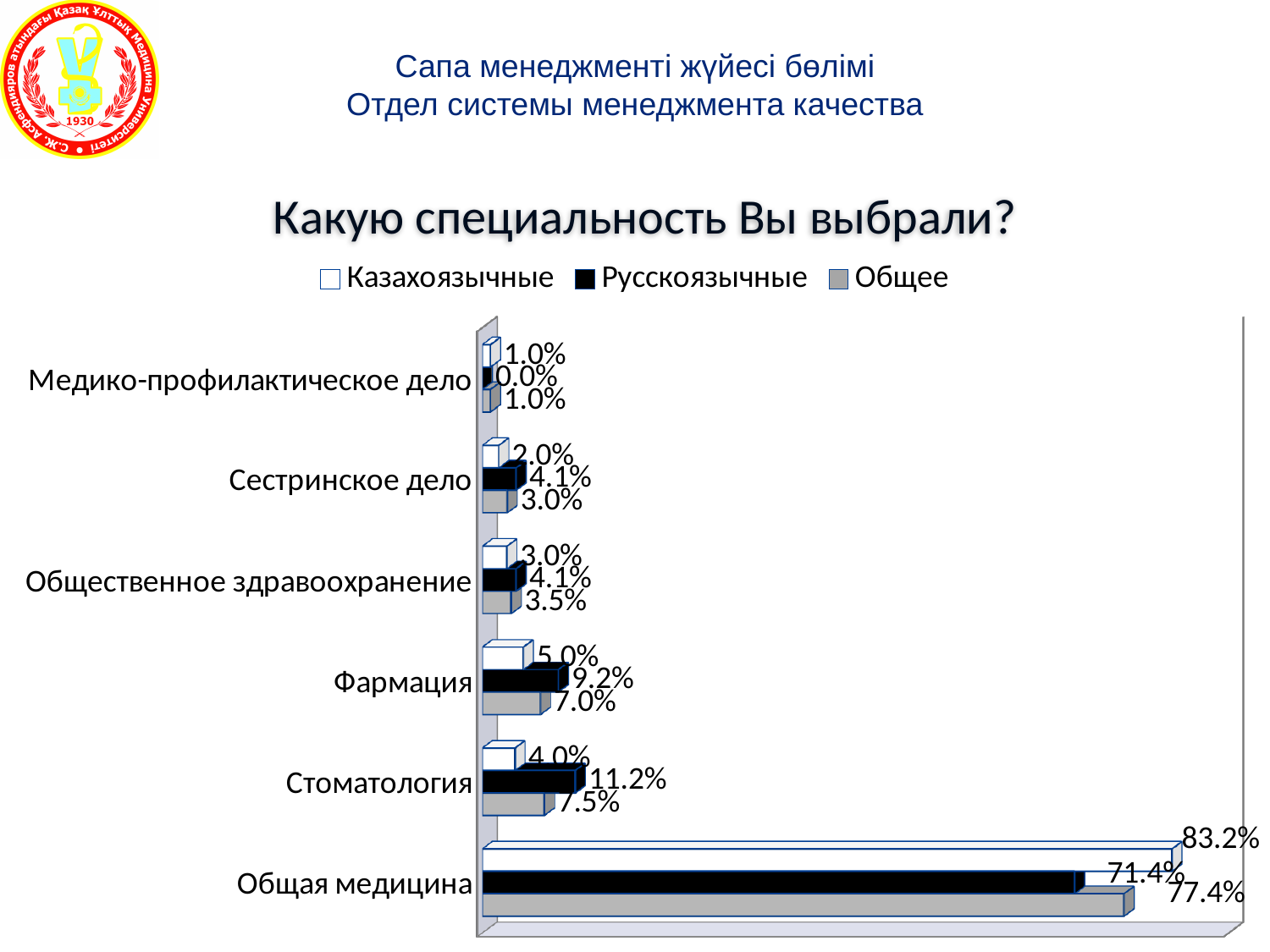
For Стоматология, which series has the larger value: Казахоязычные or Русскоязычные? Русскоязычные What is the value for Общая медицина in the Казахоязычные series? 83.2% Which category has the lowest value in the Казахоязычные series? Медико-профилактическое дело What is the difference between the Казахоязычные and Русскоязычные values for Общая медицина? 11.8% What kind of chart is shown on the slide? Bar chart What is the value for Фармация in the Общее series? 7.0% How many categories are shown on the chart? 6 What is the value for Стоматология in the Русскоязычные series? 11.2% How many series does the legend list? 3 Which category has the highest value in the Общее series? Общая медицина What is the title of the chart? Какую специальность Вы выбрали? What is the value for Медико-профилактическое дело in the Русскоязычные series? 0.0%